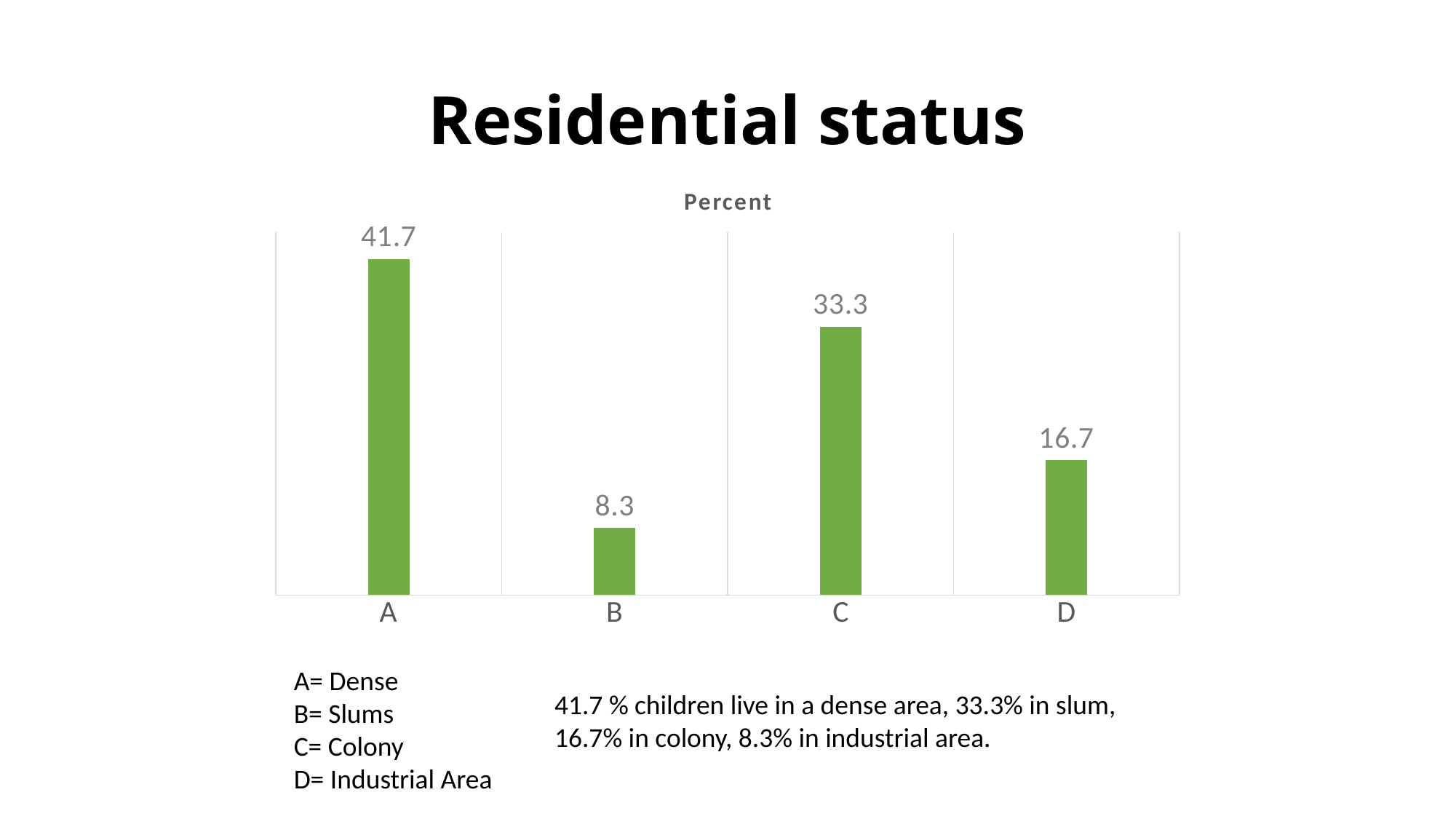
What is the value for category B? 8.3 How many categories are shown on the x axis? 4 What is the value for category A? 41.7 Which category has the lowest value? B Which category has the highest value? A What is the difference between the values for A and C? 8.4 What is the value for category D? 16.7 What kind of chart is shown on the slide? Bar chart What is the difference between the values for D and B? 8.4 What is the value for category C? 33.3 Which is larger, the value for C or the value for D? C What is the title of the chart? Percent